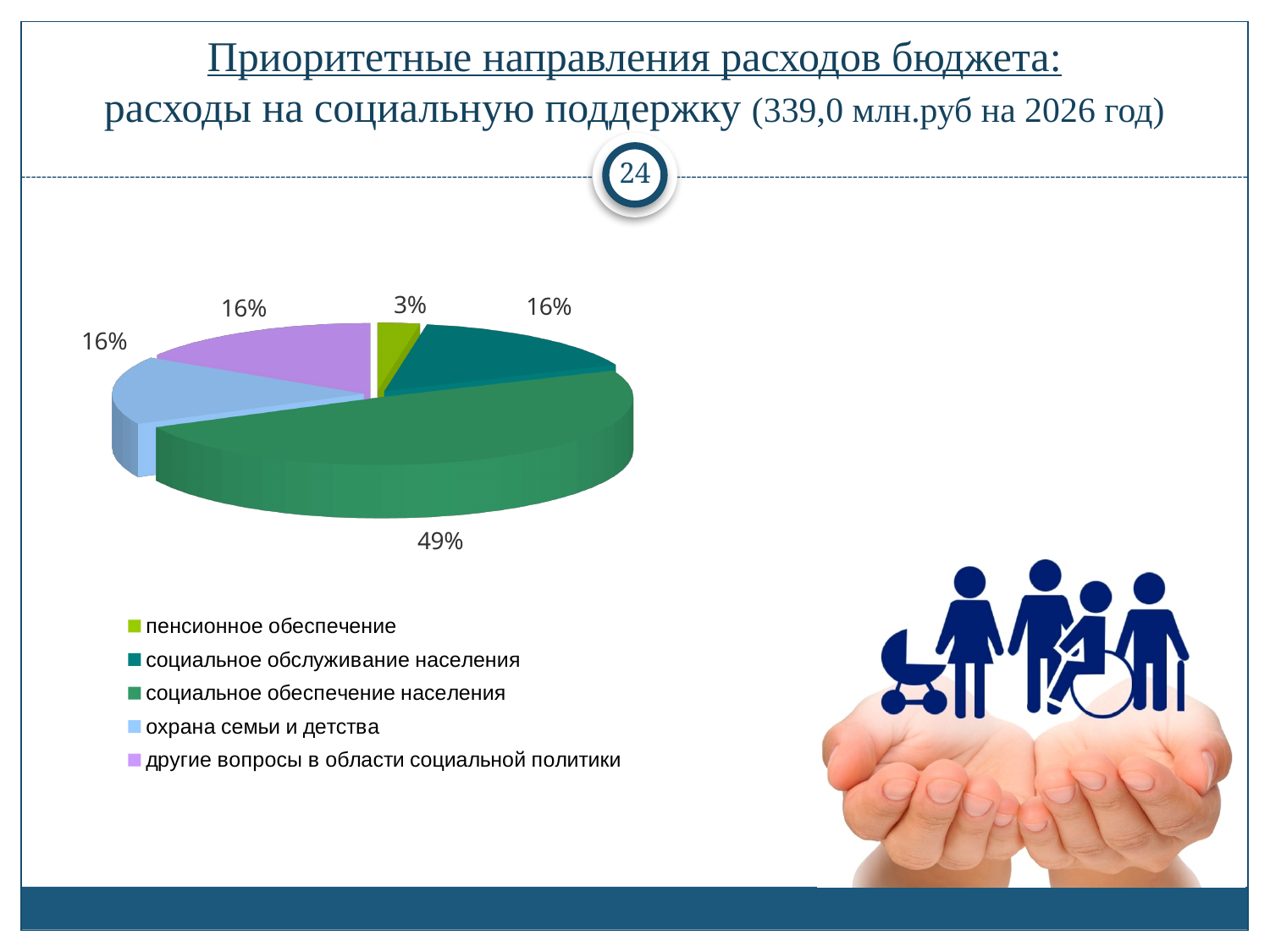
What share of the pie does "охрана семьи и детства" have? 16% How many entries does the legend list? 5 How many slices does the pie chart have? 5 Which is larger: the slice for "социальное обслуживание населения" or the slice for "пенсионное обеспечение"? социальное обслуживание населения What share of the pie does "другие вопросы в области социальной политики" have? 16% Which category has the smallest slice of the pie? пенсионное обеспечение What type of chart is shown on the slide? pie chart What is the difference in percentage points between "социальное обеспечение населения" and "пенсионное обеспечение"? 46 Which category has the largest slice of the pie? социальное обеспечение населения What share of the pie does "пенсионное обеспечение" have? 3% What total amount in million rubles for 2026 is stated in the slide title? 339,0 млн.руб What share of the pie does "социальное обеспечение населения" have? 49%